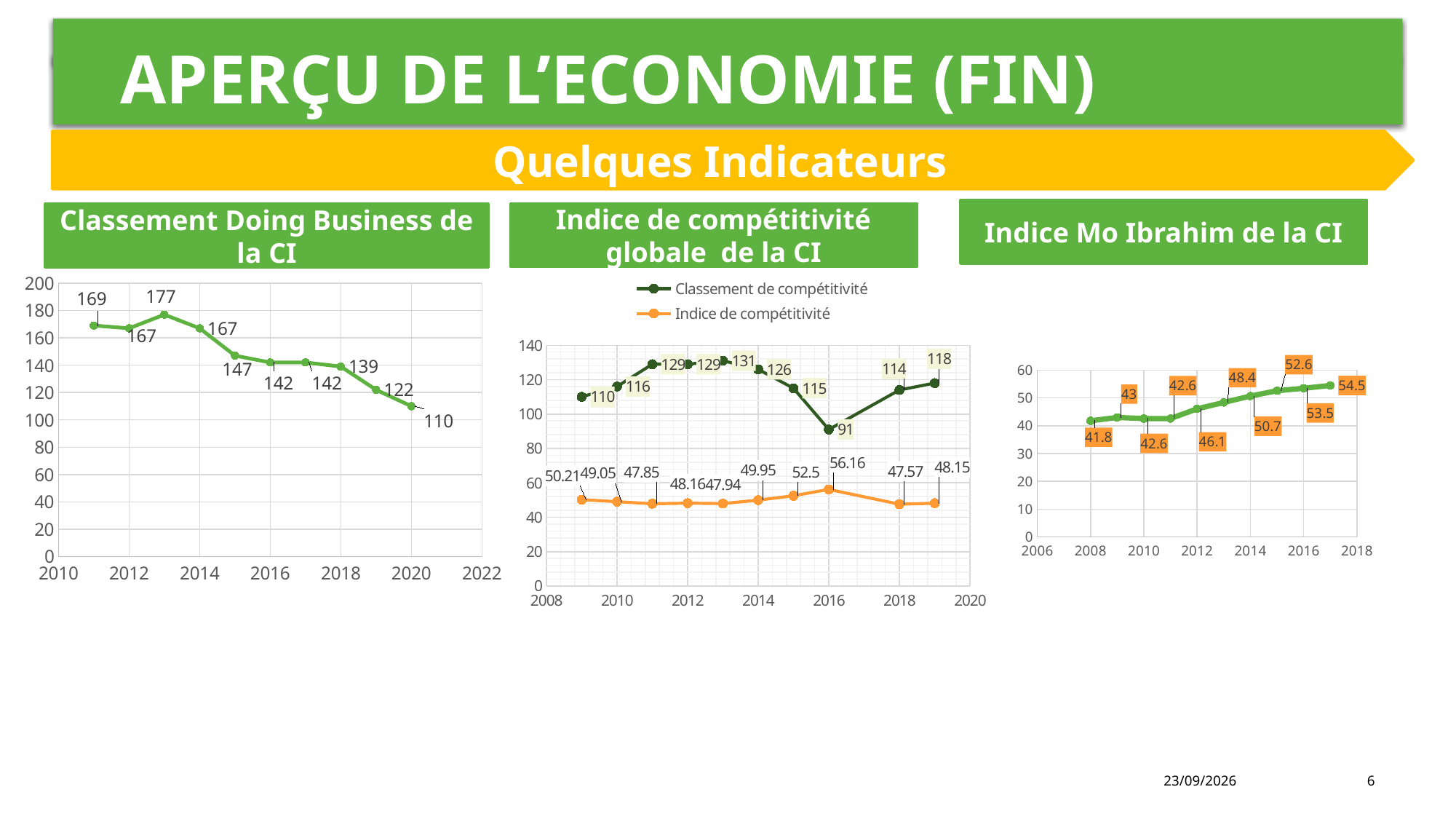
In the 'Classement Doing Business de la CI' chart, what is the value for 2013? 177 In the 'Indice Mo Ibrahim de la CI' chart, what is the difference between the 2015 value and the 2014 value? 1.9 In the 'Indice de compétitivité globale de la CI' chart, which is larger: the 'Classement de compétitivité' value for 2013 or for 2019? 2013 In the 'Indice Mo Ibrahim de la CI' chart, what is the value for 2017? 54.5 In the 'Indice de compétitivité globale de la CI' chart, which year has the highest 'Indice de compétitivité' value? 2016 In the 'Classement Doing Business de la CI' chart, what is the difference between the 2011 value and the 2020 value? 59 In the 'Indice de compétitivité globale de la CI' chart, how many series does the legend list? 2 In the 'Classement Doing Business de la CI' chart, which year has the lowest value? 2020 In the 'Indice de compétitivité globale de la CI' chart, what is the 'Classement de compétitivité' value for 2016? 91 In the 'Classement Doing Business de la CI' chart, how many data points are plotted? 10 In the 'Classement Doing Business de la CI' chart, do the values generally rise or fall from 2013 to 2020? fall What type of chart is 'Indice Mo Ibrahim de la CI'? line chart